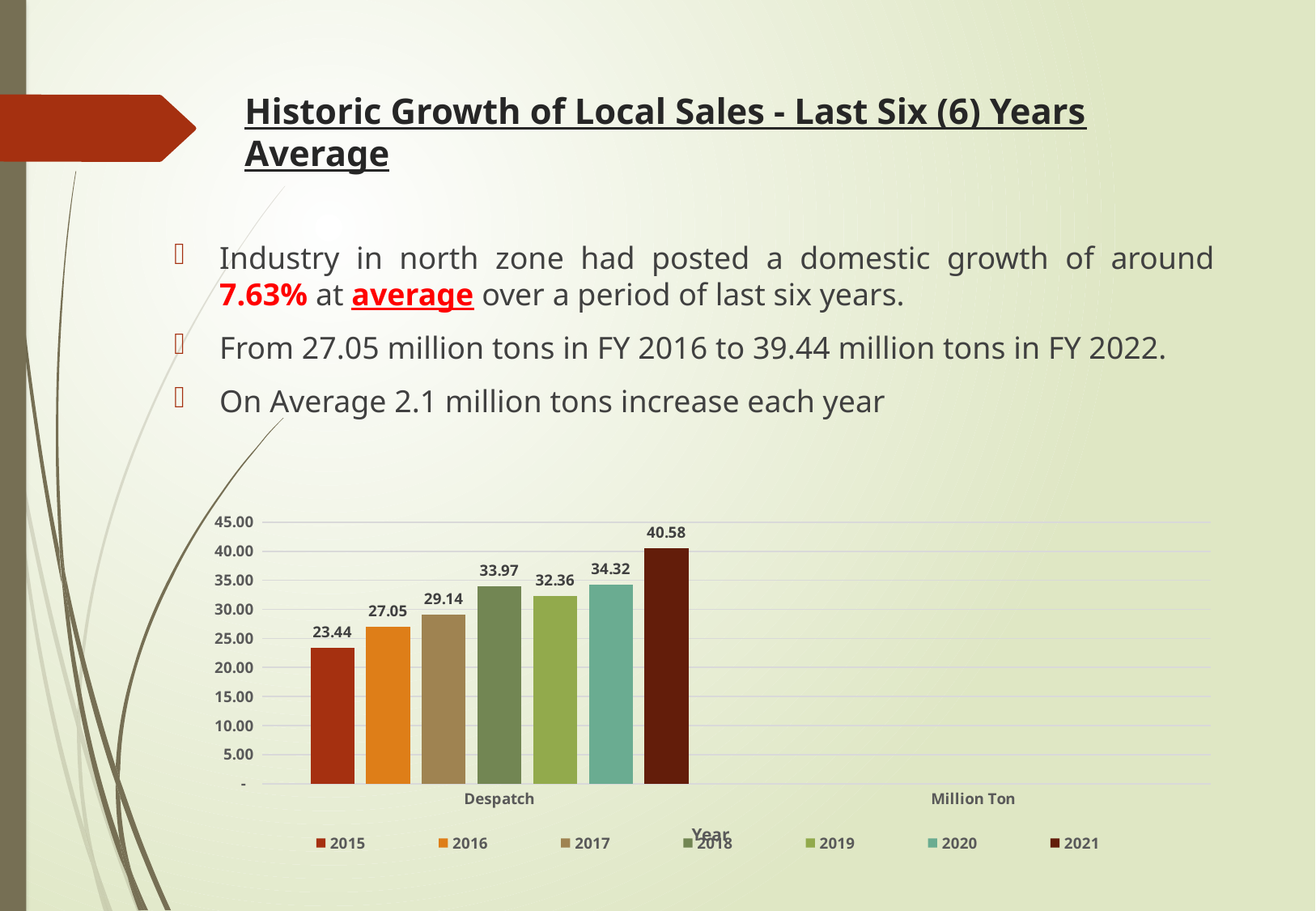
What is the label of the x axis of the chart? Year What is the value for 2021 in the chart? 40.58 What is the value for 2015 in the chart? 23.44 What is the difference between the values for 2018 and 2019? 1.61 Which is larger, the value for 2019 or the value for 2020? 2020 Is the value for 2017 greater or less than 30.00? less Which year has the lowest value in the chart? 2015 What kind of chart is shown on the slide? bar chart How many series does the legend list? 7 What is the value for 2018 in the chart? 33.97 What is the difference between the values for 2021 and 2015? 17.14 Which year has the highest value in the chart? 2021